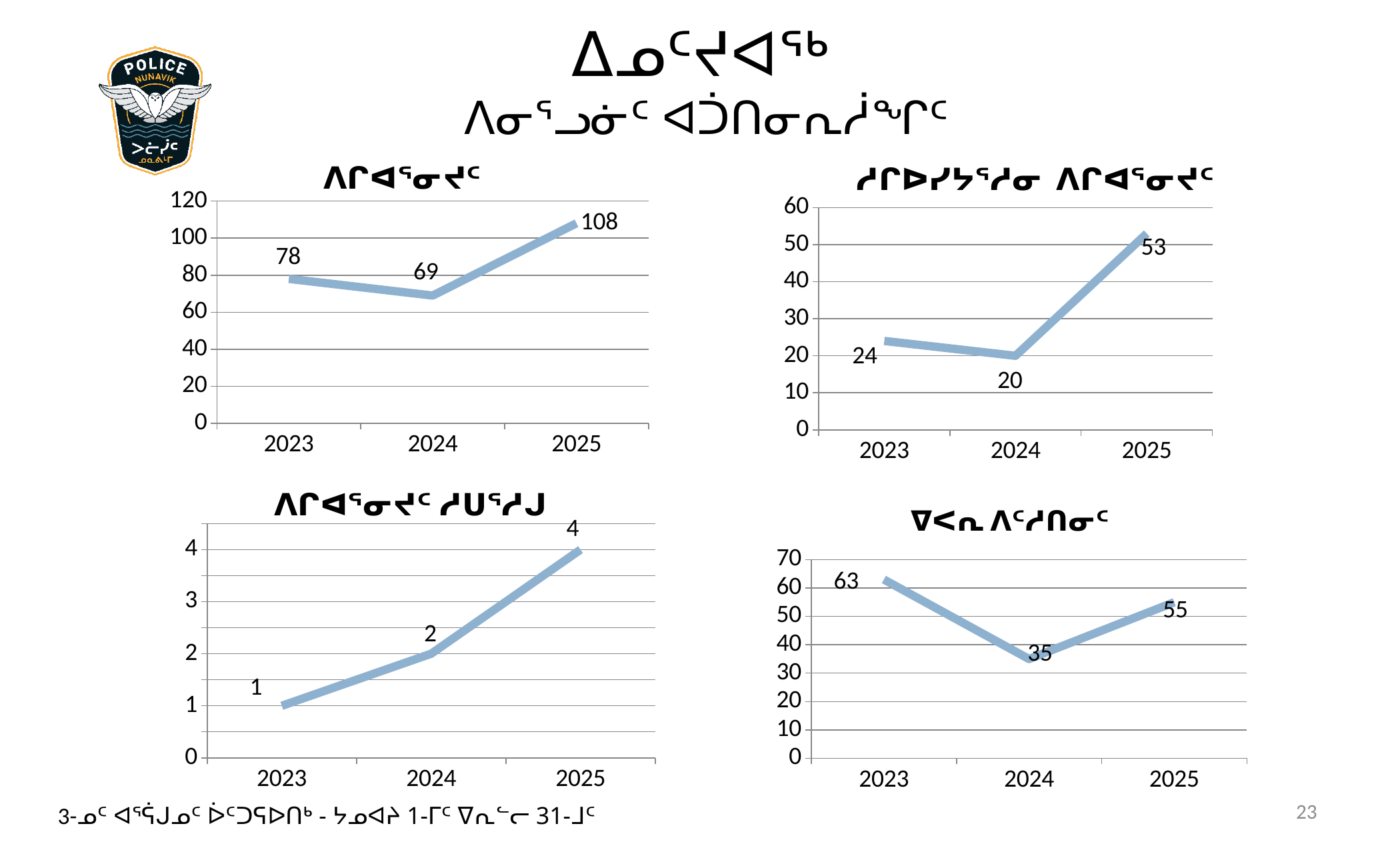
In the top-left chart, what is the value for 2025? 108 In the top-left chart, which year has the lowest value? 2024 How many data points are plotted in the bottom-right chart? 3 In the bottom-left chart, what is the value for 2024? 2 In the top-left chart, what is the difference between the 2025 and 2024 values? 39 In the top-right chart, what is the value for 2023? 24 In the bottom-right chart, what is the value for 2024? 35 In the top-right chart, which year has the highest value? 2025 In the top-right chart, is the value for 2024 larger or smaller than the value for 2023? smaller What kind of chart is the top-left chart? line chart In the bottom-left chart, do the values rise or fall from 2023 to 2025? rise In the bottom-right chart, what is the difference between the 2023 and 2025 values? 8